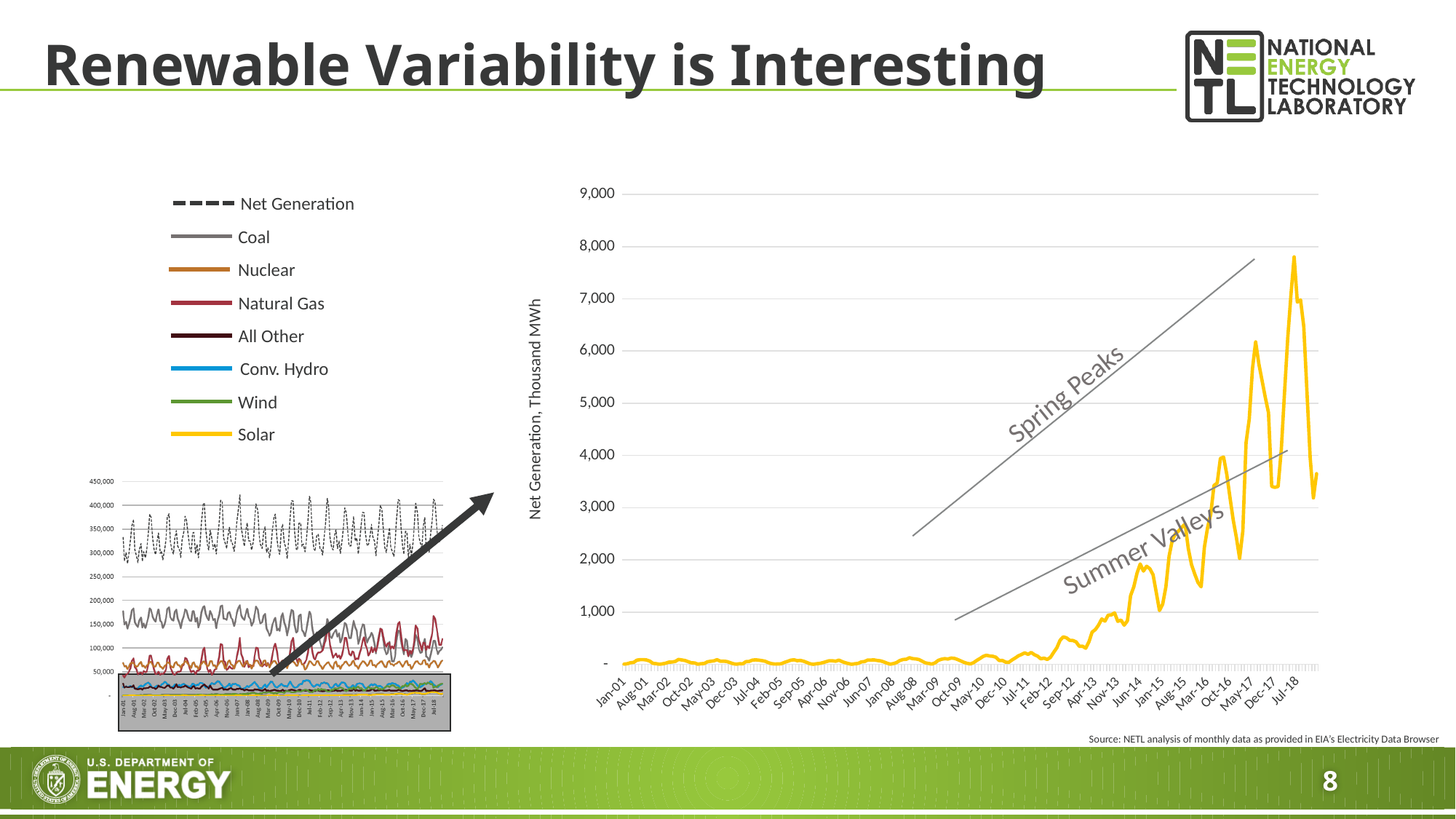
How many series does the legend on the left of the slide list? 8 In the large chart on the right, what are the two annotations written along the grey trend lines? Spring Peaks and Summer Valleys In the large chart on the right, what is the y-axis title? Net Generation, Thousand MWh In the small chart on the lower left, is the Net Generation series greater or less than 250,000 throughout the period? greater In the large chart on the right, is the highest peak of the solar line greater or less than 7,000? greater In the large chart on the right, does the solar net generation rise or fall over time from Jan-01 to Jul-18? rise What kind of chart is the small chart on the lower left of the slide? line chart In the small chart on the lower left, which series is larger, Coal or Nuclear? Coal What kind of chart is the large chart on the right of the slide? line chart In the small chart on the lower left, is the Nuclear series greater or less than 150,000? less In the small chart on the lower left, which series has the highest values? Net Generation